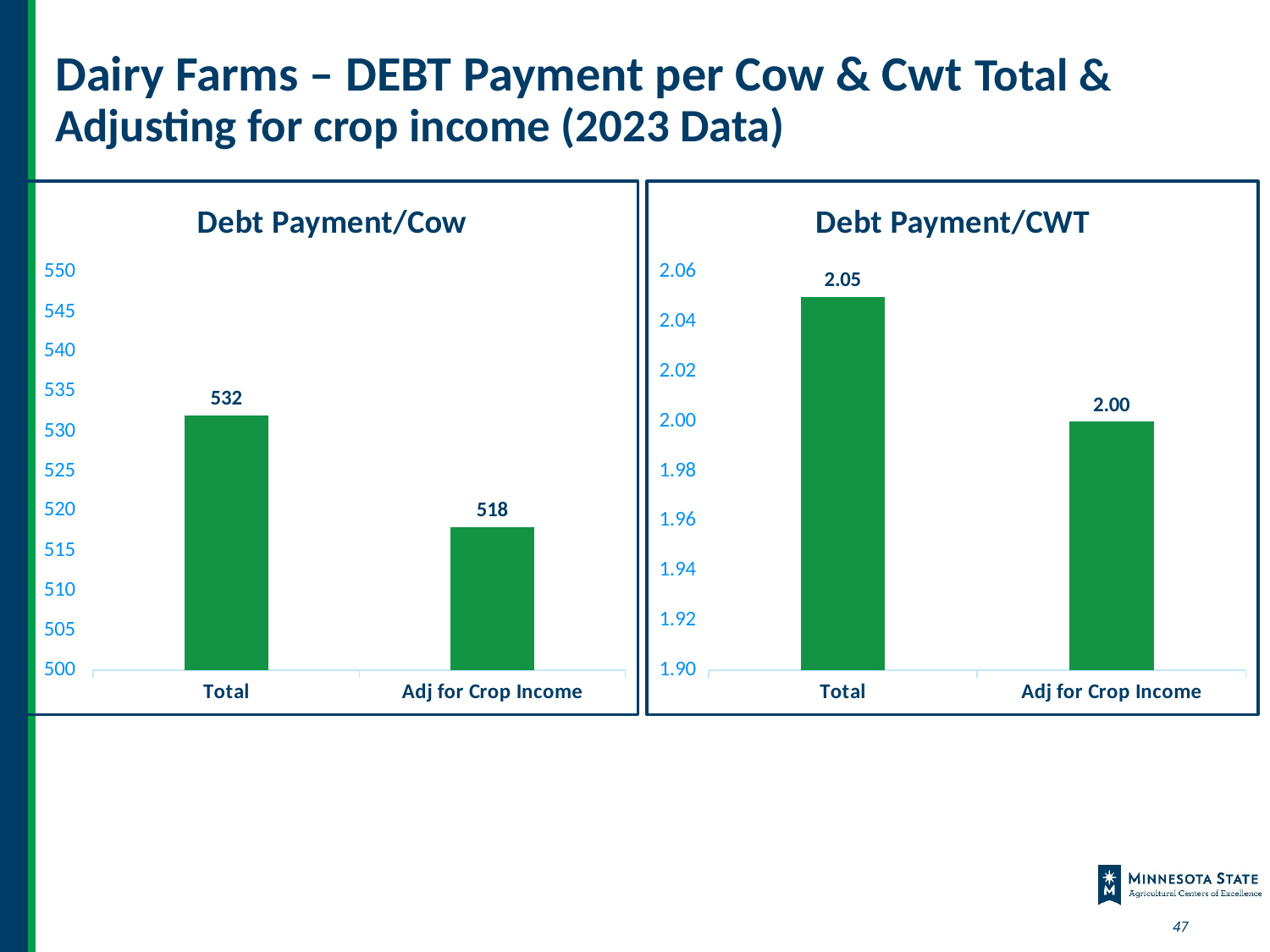
In the Debt Payment/CWT chart, what is the value for Total? 2.05 In the Debt Payment/Cow chart, what is the value for Adj for Crop Income? 518 In the Debt Payment/Cow chart, is the value for Adj for Crop Income greater or less than 520? less In the Debt Payment/CWT chart, do the values rise or fall from Total to Adj for Crop Income? fall In the Debt Payment/CWT chart, what is the value for Adj for Crop Income? 2.00 In the Debt Payment/CWT chart, what is the difference between Total and Adj for Crop Income? 0.05 In the Debt Payment/Cow chart, what is the difference between Total and Adj for Crop Income? 14 How many categories are shown in the Debt Payment/CWT chart? 2 In the Debt Payment/Cow chart, what is the value for Total? 532 What kind of chart is the Debt Payment/Cow chart? bar chart In the Debt Payment/Cow chart, which category has the highest value? Total In the Debt Payment/CWT chart, which category has the lowest value? Adj for Crop Income